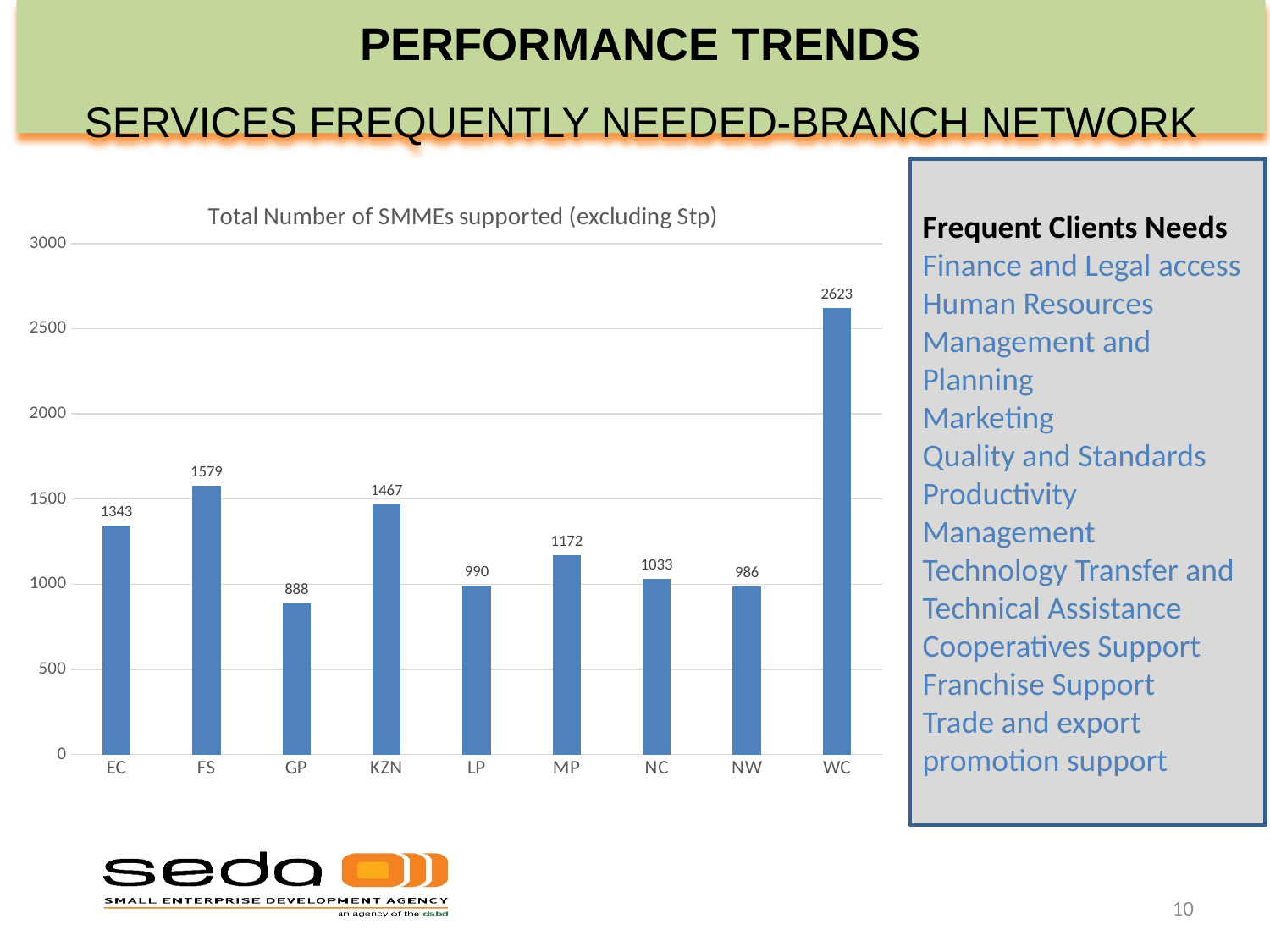
What is the difference between the values for EC and GP? 455 Is the value for NW greater or less than 1000? less Which is larger, the value for LP or the value for MP? MP Which province has the highest number of SMMEs supported? WC Which province has the lowest number of SMMEs supported? GP What is the difference between the values for WC and FS? 1044 What is the value for KZN in the chart? 1467 How many provinces are shown on the x axis of the chart? 9 What is the maximum value shown on the y axis of the chart? 3000 What is the value for NC in the chart? 1033 What kind of chart is shown on the slide? bar chart What is the title of the chart? Total Number of SMMEs supported (excluding Stp)